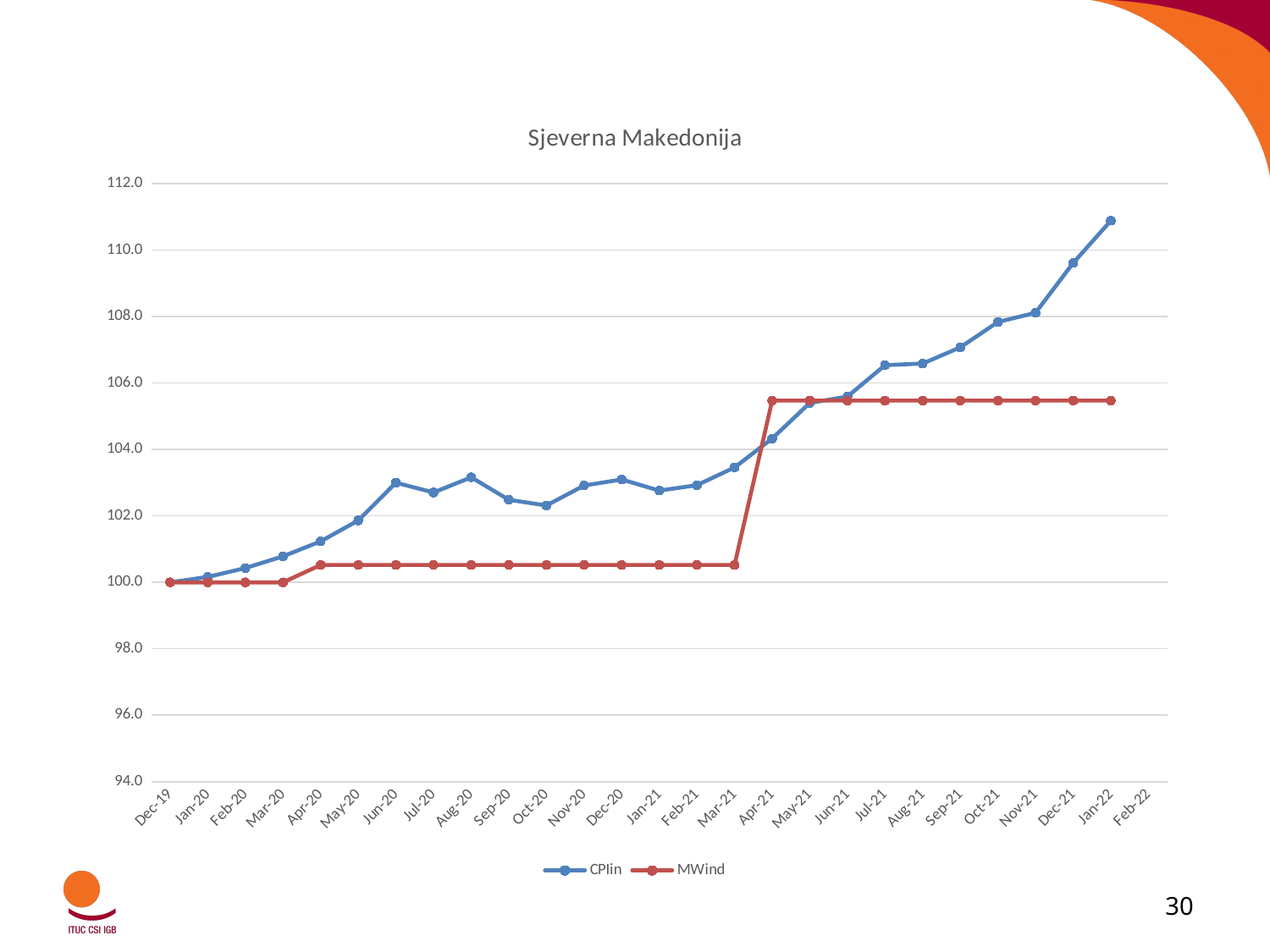
What is the value of MWind at Mar-20? 100.0 At which month does the CPIin series reach its highest value? Jan-22 Is the value of CPIin at Jun-20 greater or less than 102.0? greater At Jan-22, which series has the higher value, CPIin or MWind? CPIin How many series does the legend list? 2 What is the value of CPIin at Dec-19? 100.0 What kind of chart is shown on the slide? line chart Is the value of CPIin at Jan-22 greater or less than 110.0? greater What are the names of the two series in the legend? CPIin and MWind What is the title of the chart? Sjeverna Makedonija Is the value of MWind at Jan-22 greater or less than 106.0? less Does the CPIin series generally rise or fall from Dec-19 to Jan-22? rise